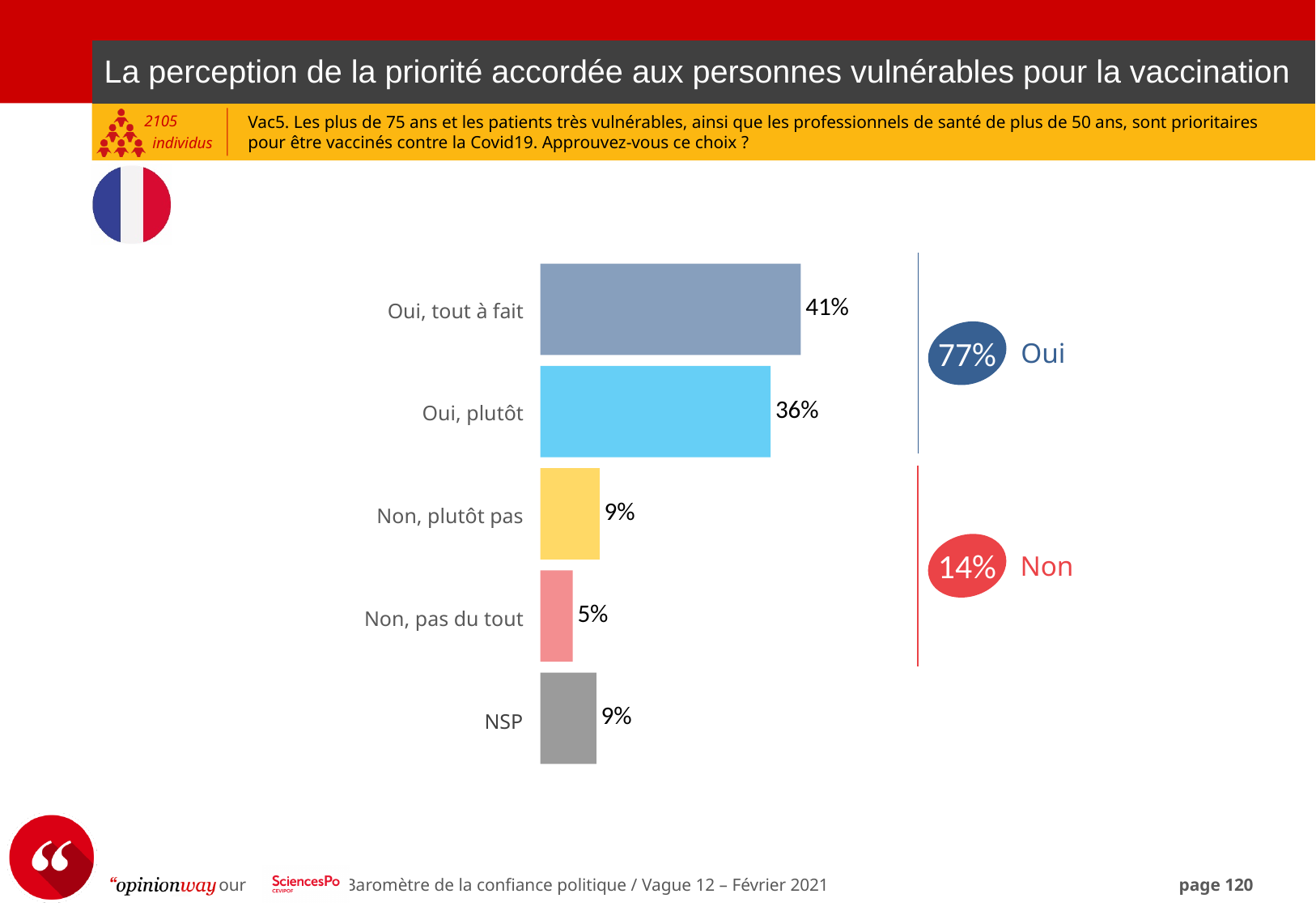
What is the value for "Non, pas du tout"? 5% Which category has the highest value? Oui, tout à fait Which category has the lowest value? Non, pas du tout What kind of chart is shown on the slide? Bar chart How many categories are shown in the bar chart? 5 What is the value for "NSP"? 9% What is the value for "Oui, tout à fait"? 41% Which is larger, "Non, plutôt pas" or "Non, pas du tout"? Non, plutôt pas What is the combined total shown for "Oui" responses? 77% What is the difference between "Oui, tout à fait" and "Oui, plutôt"? 5% What is the value for "Oui, plutôt"? 36% What is the combined total shown for "Non" responses? 14%